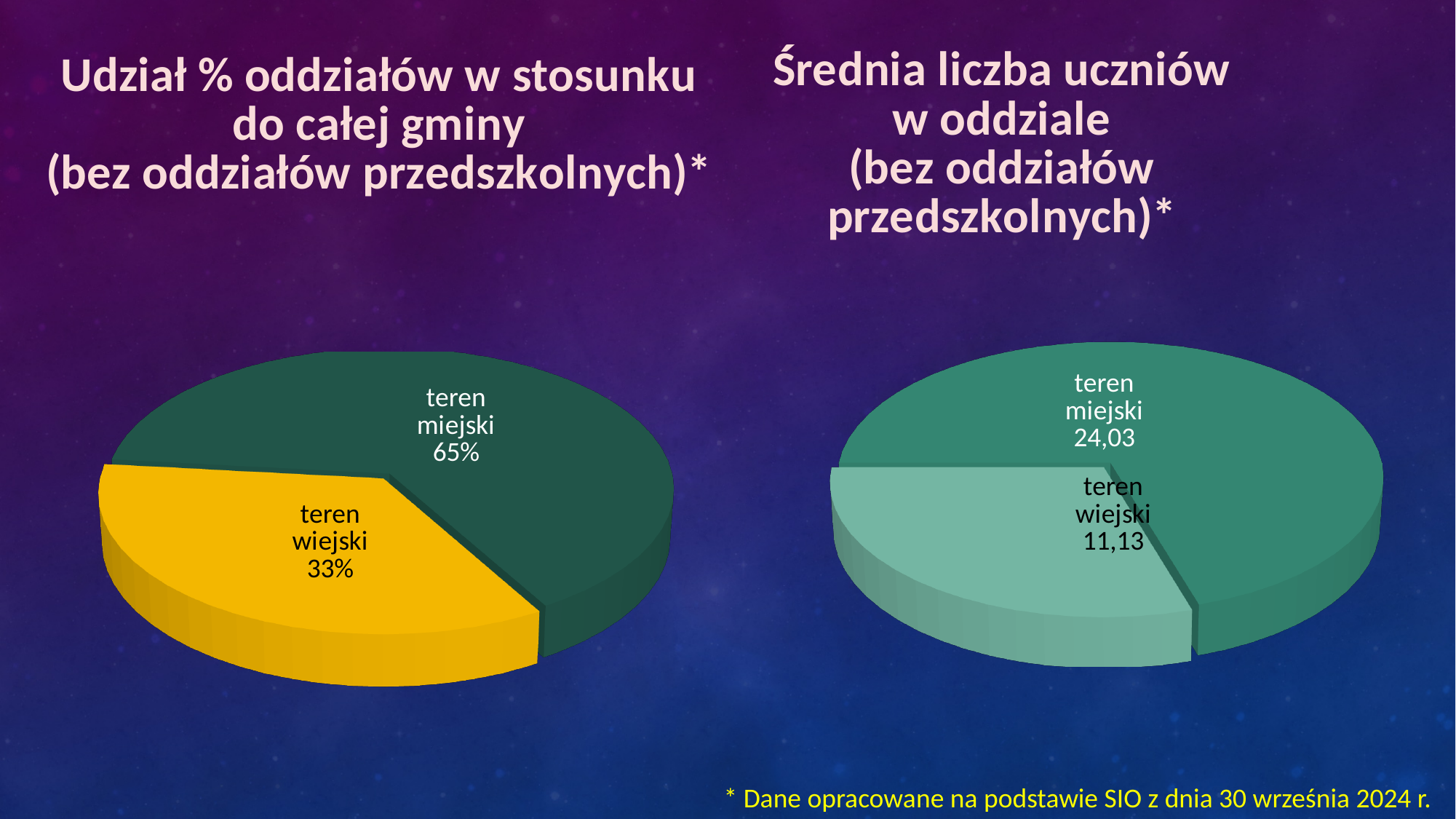
In the left chart (Udział % oddziałów w stosunku do całej gminy), which category has the largest share? teren miejski In the left chart (Udział % oddziałów w stosunku do całej gminy), what is the difference in percentage points between teren miejski and teren wiejski? 32 In the right chart (Średnia liczba uczniów w oddziale), what is the difference between the values for teren miejski and teren wiejski? 12,90 What type of chart is the right chart (Średnia liczba uczniów w oddziale)? pie chart In the right chart (Średnia liczba uczniów w oddziale), which category has the lowest value? teren wiejski How many categories does the left chart (Udział % oddziałów w stosunku do całej gminy) show? 2 In the right chart (Średnia liczba uczniów w oddziale), which is larger: teren miejski or teren wiejski? teren miejski In the left chart (Udział % oddziałów w stosunku do całej gminy), what is the value for teren miejski? 65% In the left chart (Udział % oddziałów w stosunku do całej gminy), what colour is the teren wiejski slice? yellow In the right chart (Średnia liczba uczniów w oddziale), what is the value for teren miejski? 24,03 In the left chart (Udział % oddziałów w stosunku do całej gminy), what is the value for teren wiejski? 33% In the right chart (Średnia liczba uczniów w oddziale), what is the value for teren wiejski? 11,13